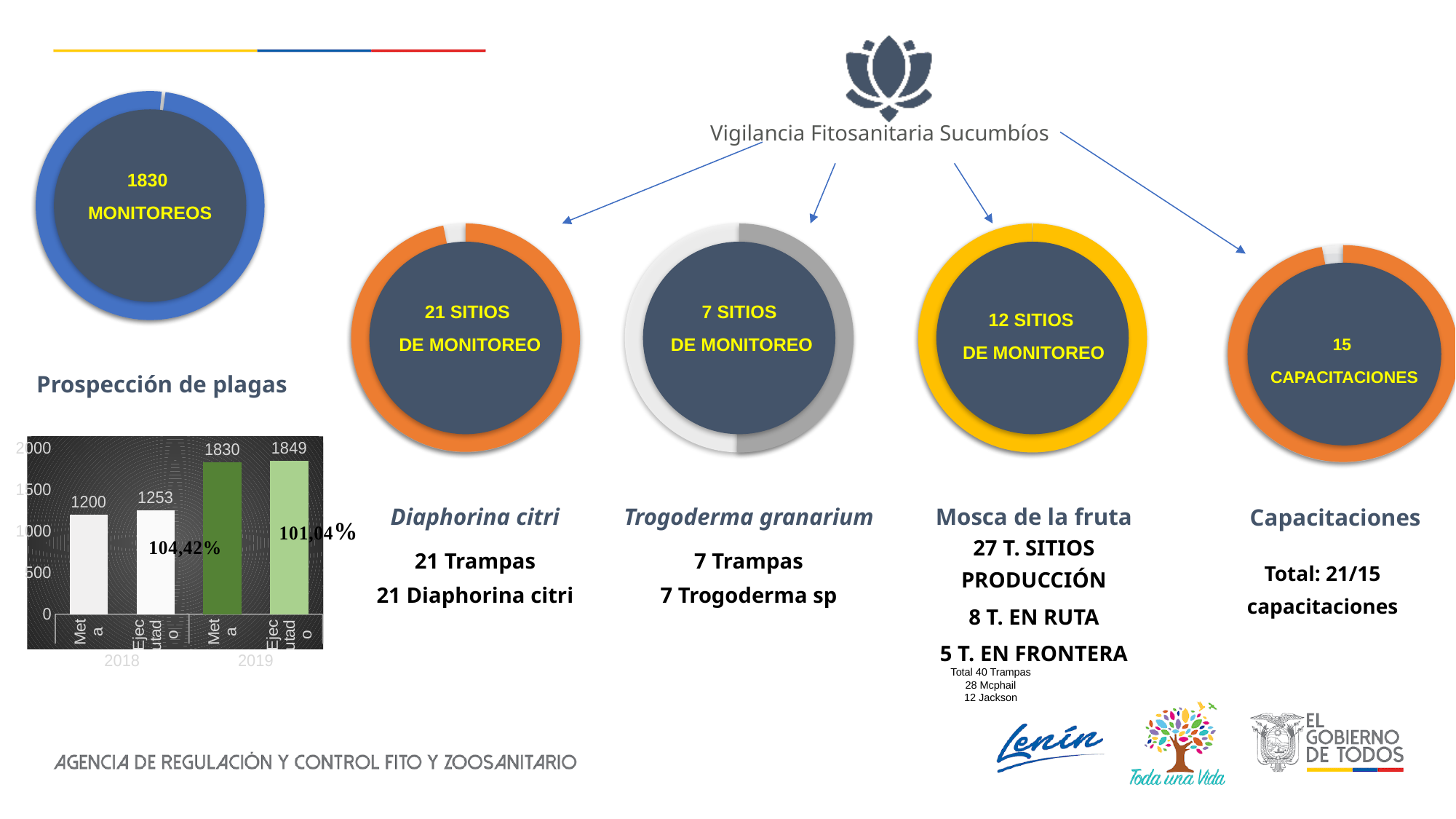
In the bar chart under 'Prospección de plagas', what percentage label is shown for 2018? 104,42% In the bar chart under 'Prospección de plagas', what is the difference between Ejecutado 2019 and Meta 2019? 19 What value is shown in the centre of the blue donut chart at the top left? 1830 MONITOREOS In the bar chart under 'Prospección de plagas', what is the value of Ejecutado for 2019? 1849 In the bar chart under 'Prospección de plagas', what is the value of Meta for 2018? 1200 What value is shown in the centre of the yellow donut chart above 'Mosca de la fruta'? 12 SITIOS DE MONITOREO In the bar chart under 'Prospección de plagas', how many bars are plotted? 4 In the bar chart under 'Prospección de plagas', which bar has the lowest value? Meta 2018 In the bar chart under 'Prospección de plagas', what is the value of Ejecutado for 2018? 1253 In the bar chart under 'Prospección de plagas', what is the difference between Ejecutado 2018 and Meta 2018? 53 What kind of chart is shown under 'Prospección de plagas'? Bar chart In the bar chart under 'Prospección de plagas', which bar has the highest value? Ejecutado 2019